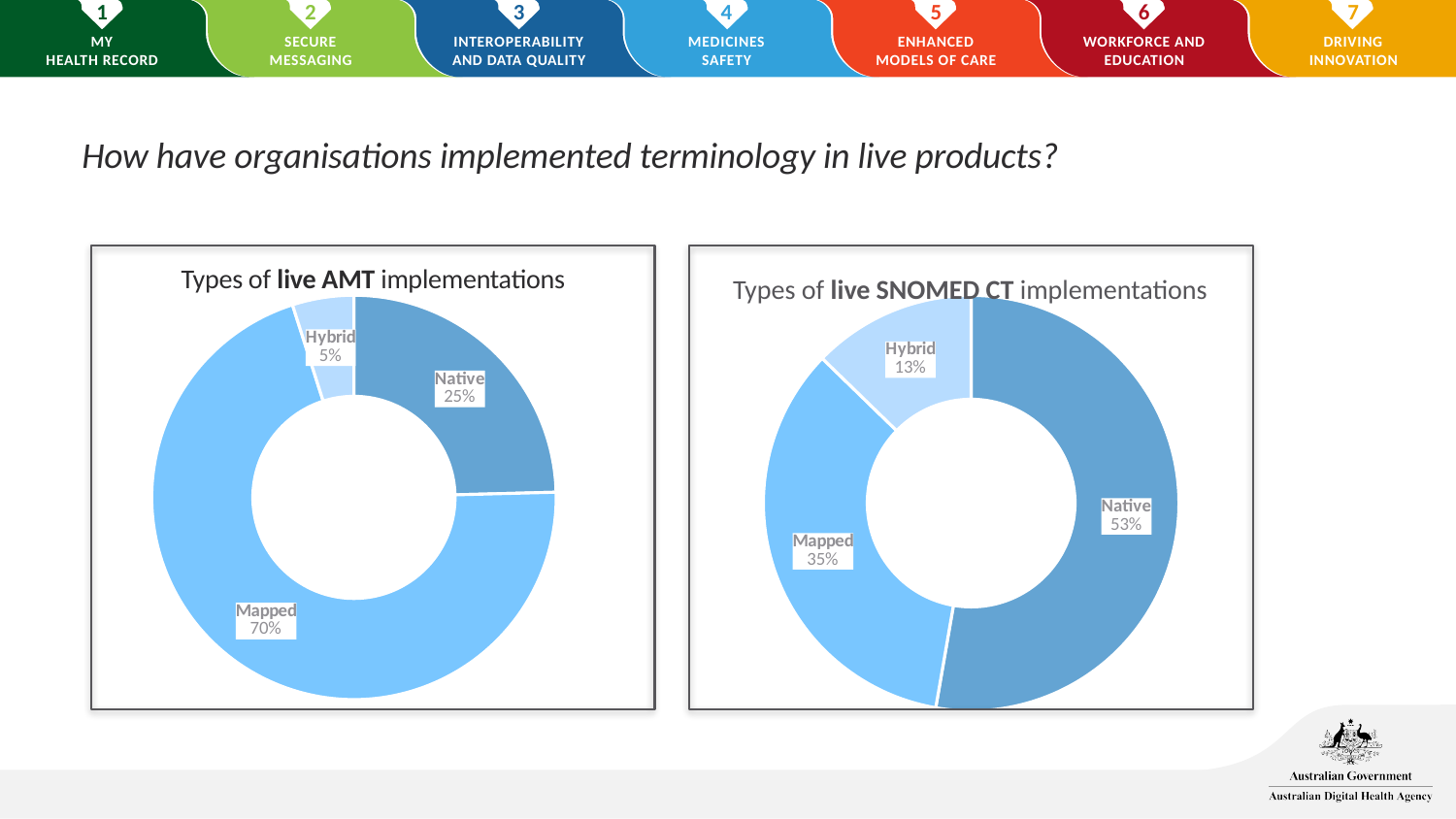
In the 'Types of live SNOMED CT implementations' chart, which category has the largest share? Native Which is larger: the Hybrid share in the 'Types of live AMT implementations' chart or the Hybrid share in the 'Types of live SNOMED CT implementations' chart? SNOMED CT What kind of chart is the 'Types of live SNOMED CT implementations' chart? Doughnut (pie) chart In the 'Types of live AMT implementations' chart, what share is Native? 25% In the 'Types of live SNOMED CT implementations' chart, which category has the smallest share? Hybrid In the 'Types of live AMT implementations' chart, what share is Mapped? 70% In the 'Types of live SNOMED CT implementations' chart, what is the difference between the Native and Mapped shares? 18% How many categories does the 'Types of live AMT implementations' chart show? 3 In the 'Types of live AMT implementations' chart, what is the difference between the Mapped and Native shares? 45% In the 'Types of live SNOMED CT implementations' chart, what share is Native? 53% In the 'Types of live AMT implementations' chart, which category has the largest share? Mapped In the 'Types of live SNOMED CT implementations' chart, what share is Hybrid? 13%